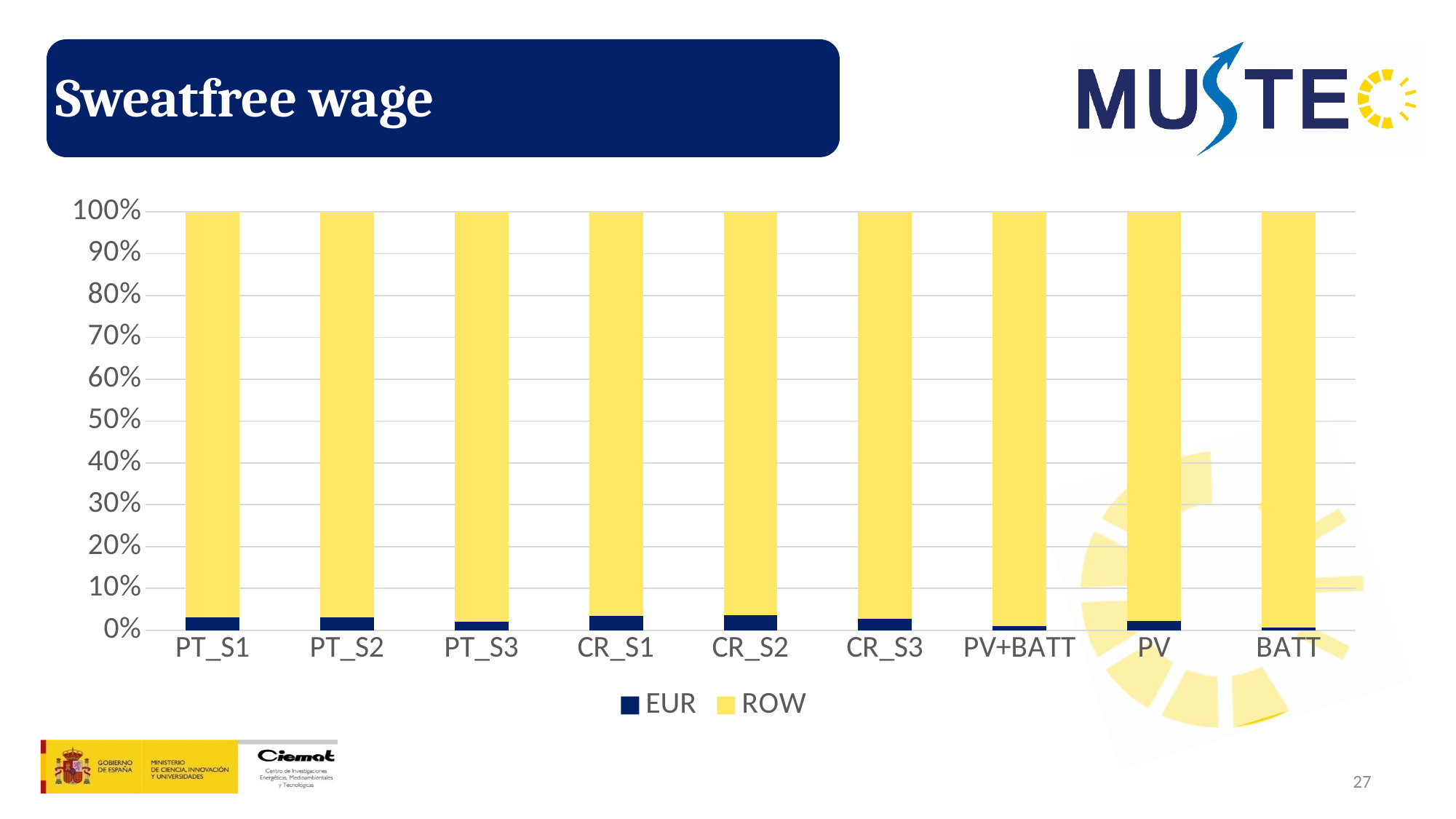
What is the title of the slide containing the chart? Sweatfree wage How many series does the legend list? 2 Is the EUR value for BATT greater or less than 10%? less What is the total height of the stacked bar for PT_S1? 100% Which series occupies the larger share of every bar, EUR or ROW? ROW What are the two series named in the legend? EUR and ROW Is the ROW value for CR_S2 greater or less than 90%? greater What kind of chart is shown on the slide? stacked bar chart Which is larger, the ROW value for PV+BATT or the EUR value for PV+BATT? ROW How many categories are shown on the x axis of the chart? 9 Is the EUR value for PT_S1 greater or less than 10%? less Which is larger, the EUR value for CR_S2 or the EUR value for BATT? CR_S2